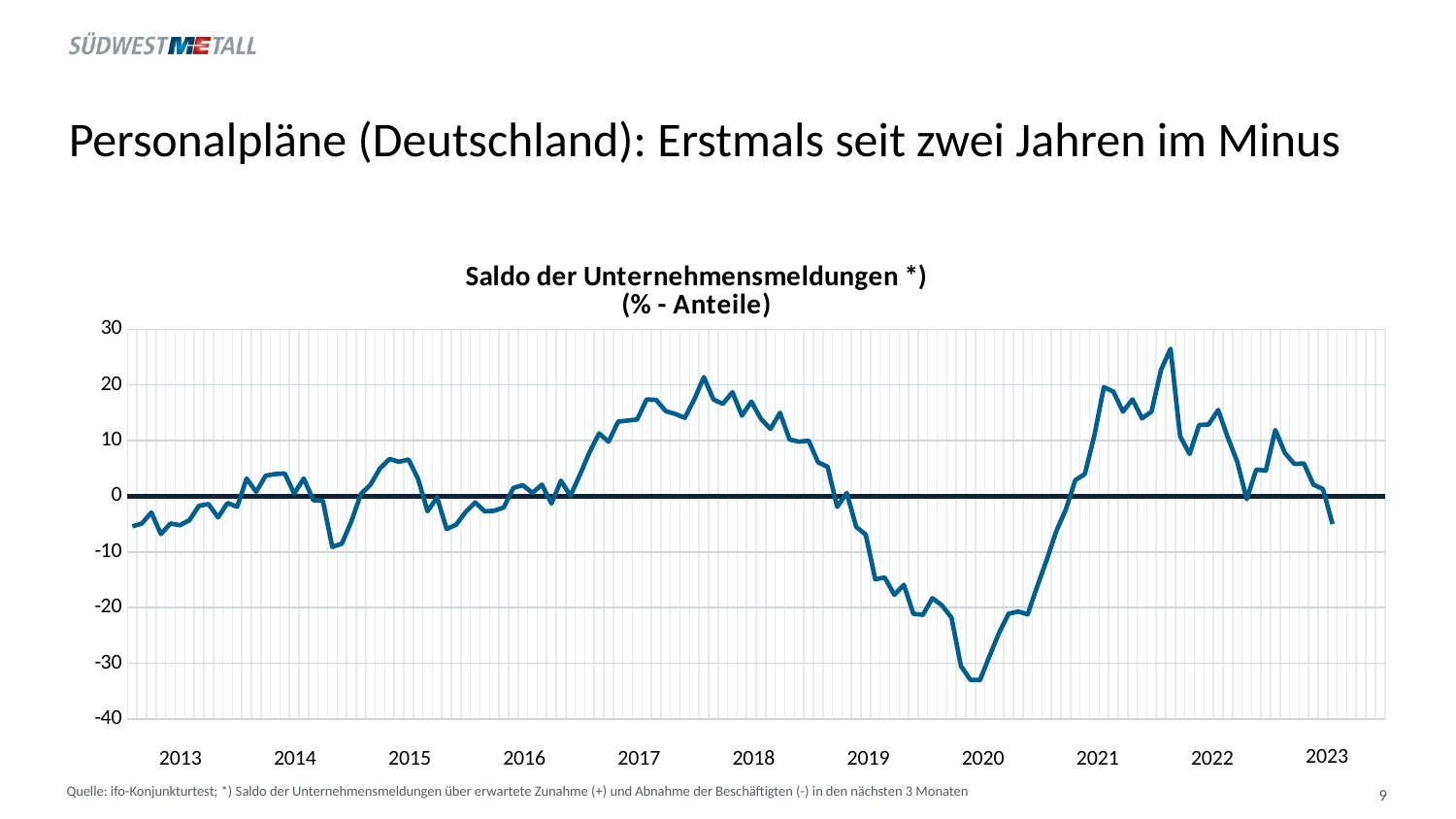
What is the title of the chart? Saldo der Unternehmensmeldungen *) (% - Anteile) Does the line rise or fall over the course of 2019? fall Is the last plotted value, in 2023, greater or less than 0? less Is the highest point of the line, reached in 2021, greater or less than 20? greater Is the first plotted value, at the start of 2013, greater or less than 0? less Does the line rise or fall from the start of 2020 to the start of 2021? rise What kind of chart is shown on the slide? line chart What is the lowest value shown on the y axis? -40 In which year does the line reach its highest value? 2021 How many year labels are shown on the x axis? 11